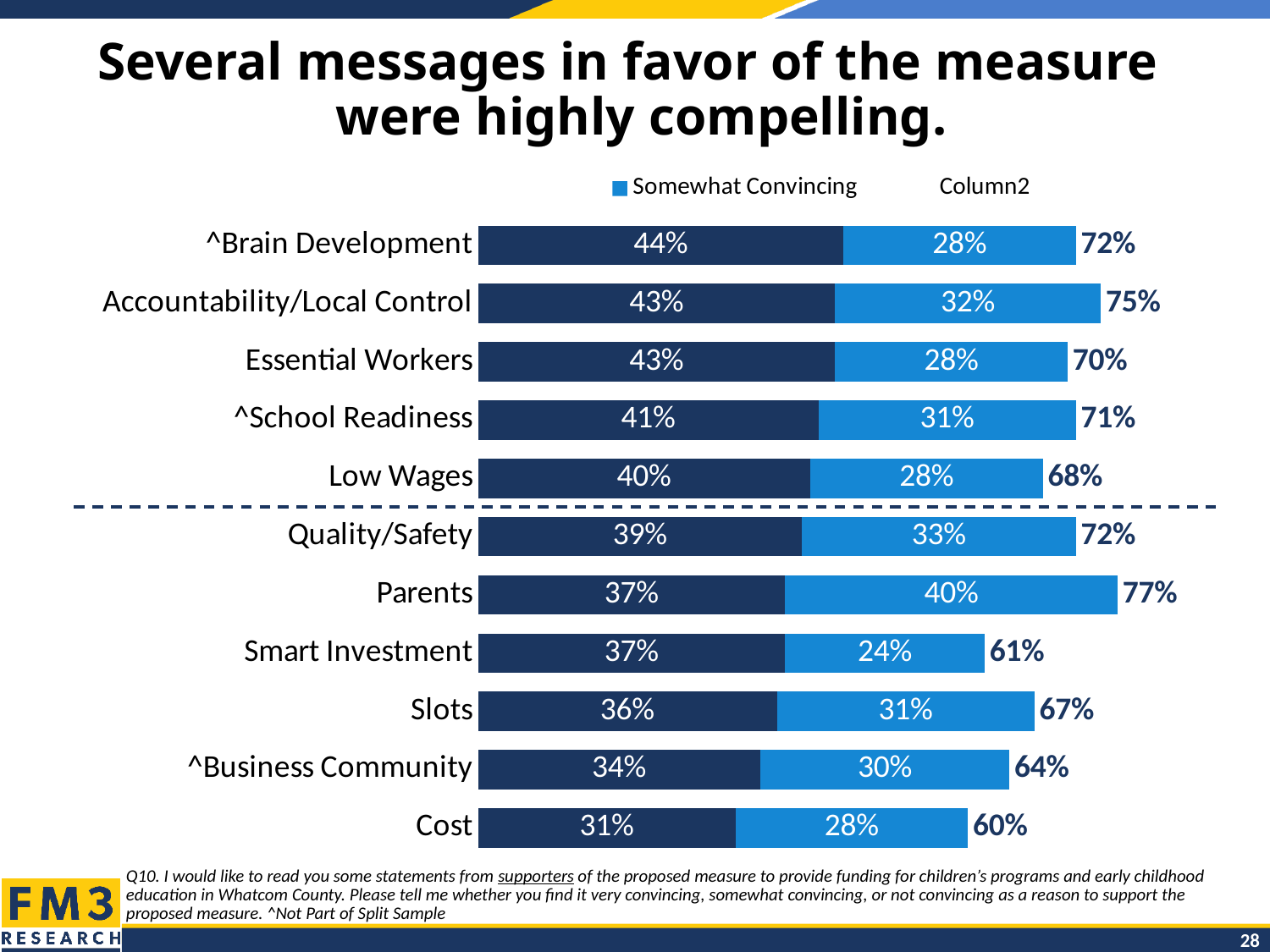
Which has a larger dark blue segment, Low Wages or Slots? Low Wages What kind of chart is shown on the slide? Stacked bar chart How many categories (messages) are plotted in the chart? 11 Which category has the highest total value? Parents Which category has the lowest total value? Cost What is the value of the light blue segment for ^Business Community? 30% What is the total value shown at the end of the bar for Parents? 77% What is the value of the dark blue segment for ^Brain Development? 44% What is the first entry listed in the chart legend? Somewhat Convincing What is the value of the light blue segment for Quality/Safety? 33% What is the difference between the total for Accountability/Local Control and the total for Smart Investment? 14% What is the total value shown for Essential Workers? 70%